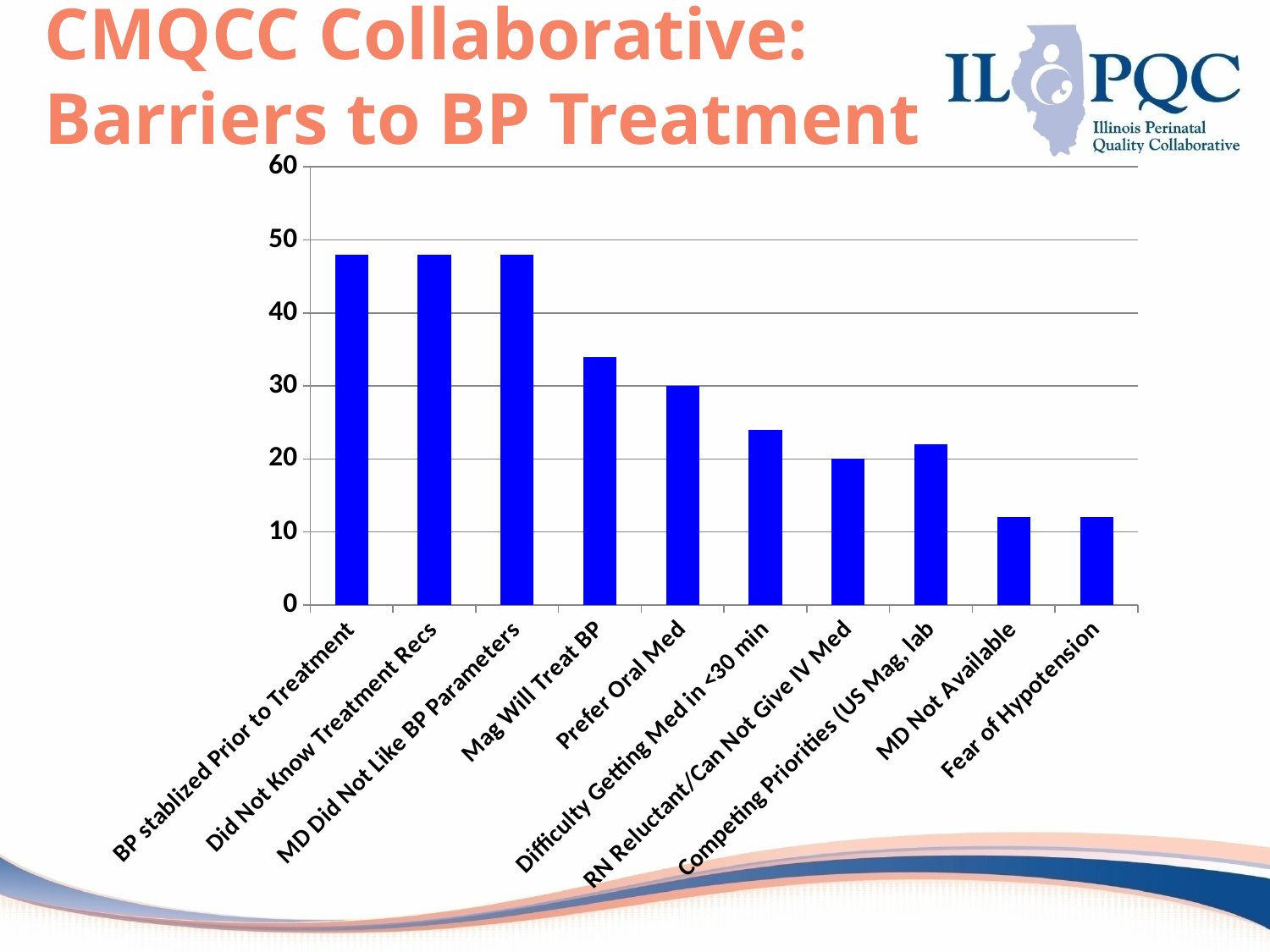
Which is larger, the value for "Did Not Know Treatment Recs" or the value for "Difficulty Getting Med in <30 min"? Did Not Know Treatment Recs Do the bar values generally rise or fall moving from left to right along the x axis? fall Is the value for "Mag Will Treat BP" greater or less than 30? greater Is the value for "BP stablized Prior to Treatment" greater or less than 40? greater Is the value for "Fear of Hypotension" greater or less than 20? less Which is larger, the value for "Mag Will Treat BP" or the value for "Prefer Oral Med"? Mag Will Treat BP How many barrier categories are plotted on the x axis? 10 What is the title of the slide containing the chart? CMQCC Collaborative: Barriers to BP Treatment What kind of chart is shown on the slide? Bar chart